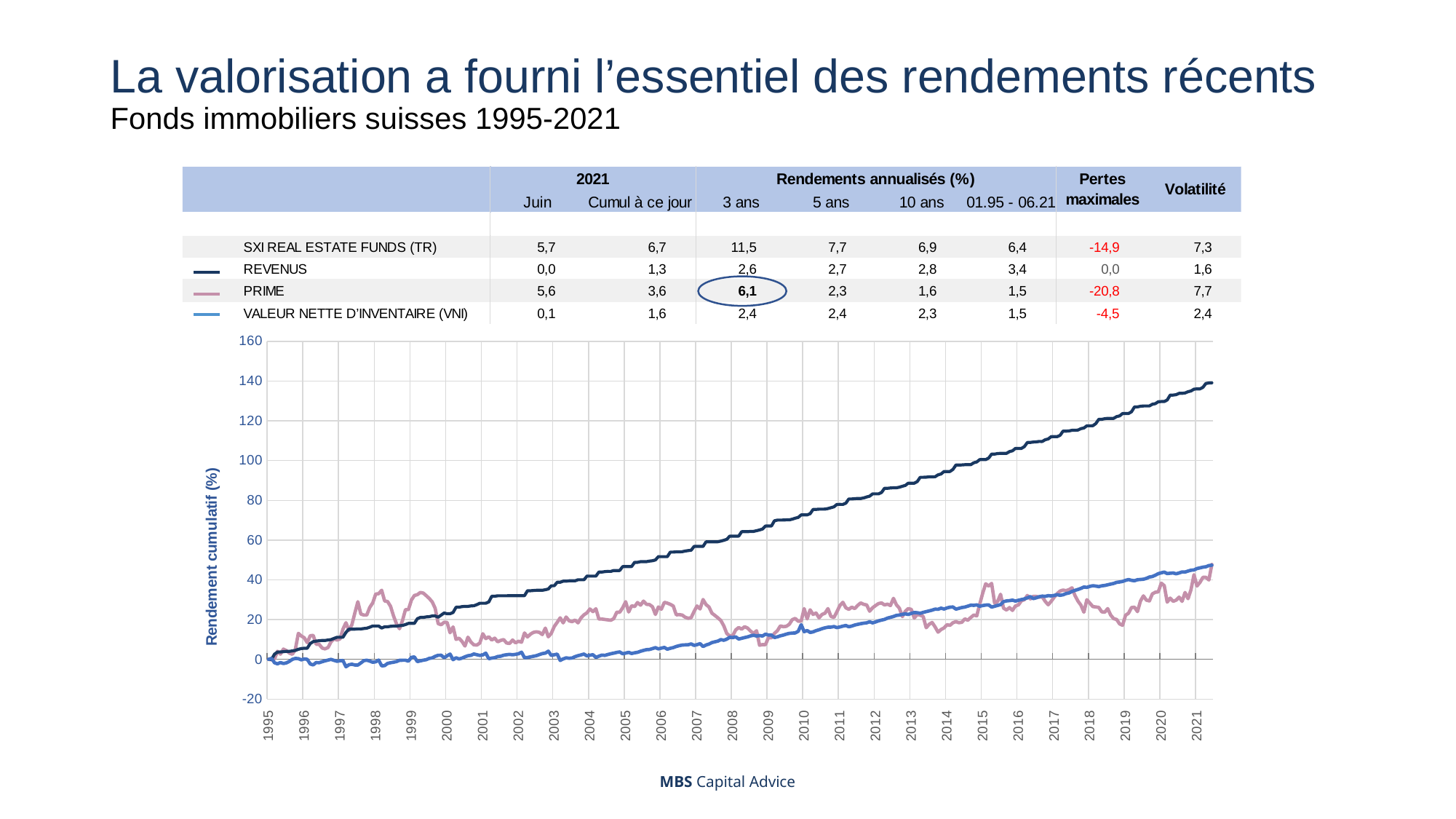
Does the REVENUS line rise or fall from 1995 to 2021? rise How many series are plotted in the line chart? 3 Which series has the highest cumulative return at the end of the chart in 2021? REVENUS In 2015, which is larger: the REVENUS line or the PRIME line? REVENUS Which series has the lowest cumulative return around 2000? VALEUR NETTE D'INVENTAIRE (VNI) What is the highest tick value shown on the y axis of the line chart? 160 How many year labels are shown on the x axis of the line chart? 27 What kind of chart is shown on the slide? line chart Is the value of the REVENUS line in 2010 greater or less than 60? greater What is the label of the y axis of the line chart? Rendement cumulatif (%) Is the value of the REVENUS line in 2021 greater or less than 120? greater Is the value of the VALEUR NETTE D'INVENTAIRE (VNI) line in 2010 greater or less than 40? less